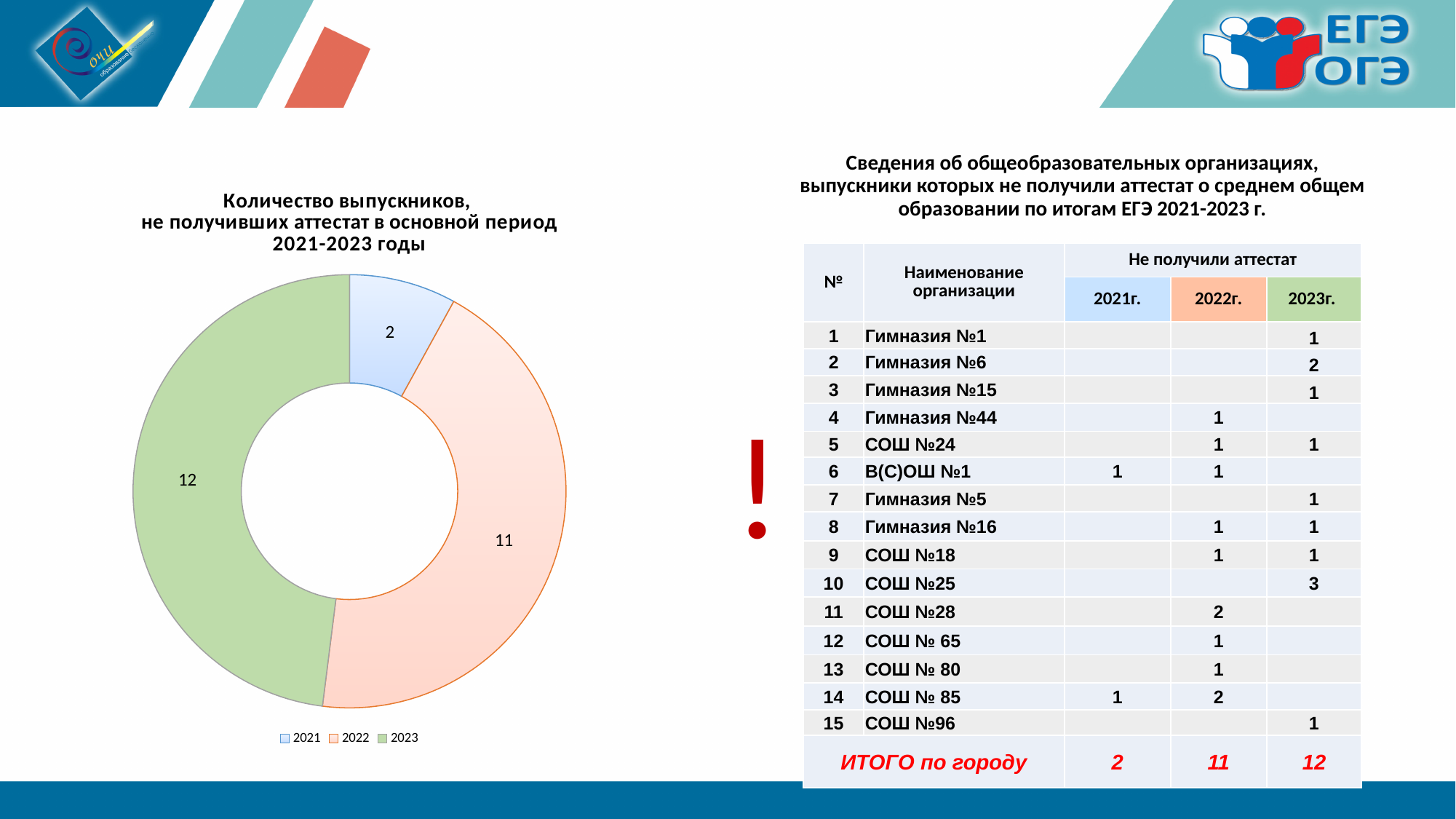
Which year has the smallest value in the doughnut chart? 2021 What is the title of the doughnut chart? Количество выпускников, не получивших аттестат в основной период 2021-2023 годы What is the difference between the values for 2022 and 2021 in the doughnut chart? 9 What is the value for 2022 in the doughnut chart? 11 What is the value for 2021 in the doughnut chart? 2 What is the value for 2023 in the doughnut chart? 12 Which is larger in the doughnut chart, the value for 2021 or the value for 2022? 2022 Which year has the largest value in the doughnut chart? 2023 How many categories does the doughnut chart show? 3 What share of the doughnut chart does the 2021 slice represent? 8% What is the difference between the values for 2023 and 2022 in the doughnut chart? 1 What type of chart is shown on the slide? Doughnut chart